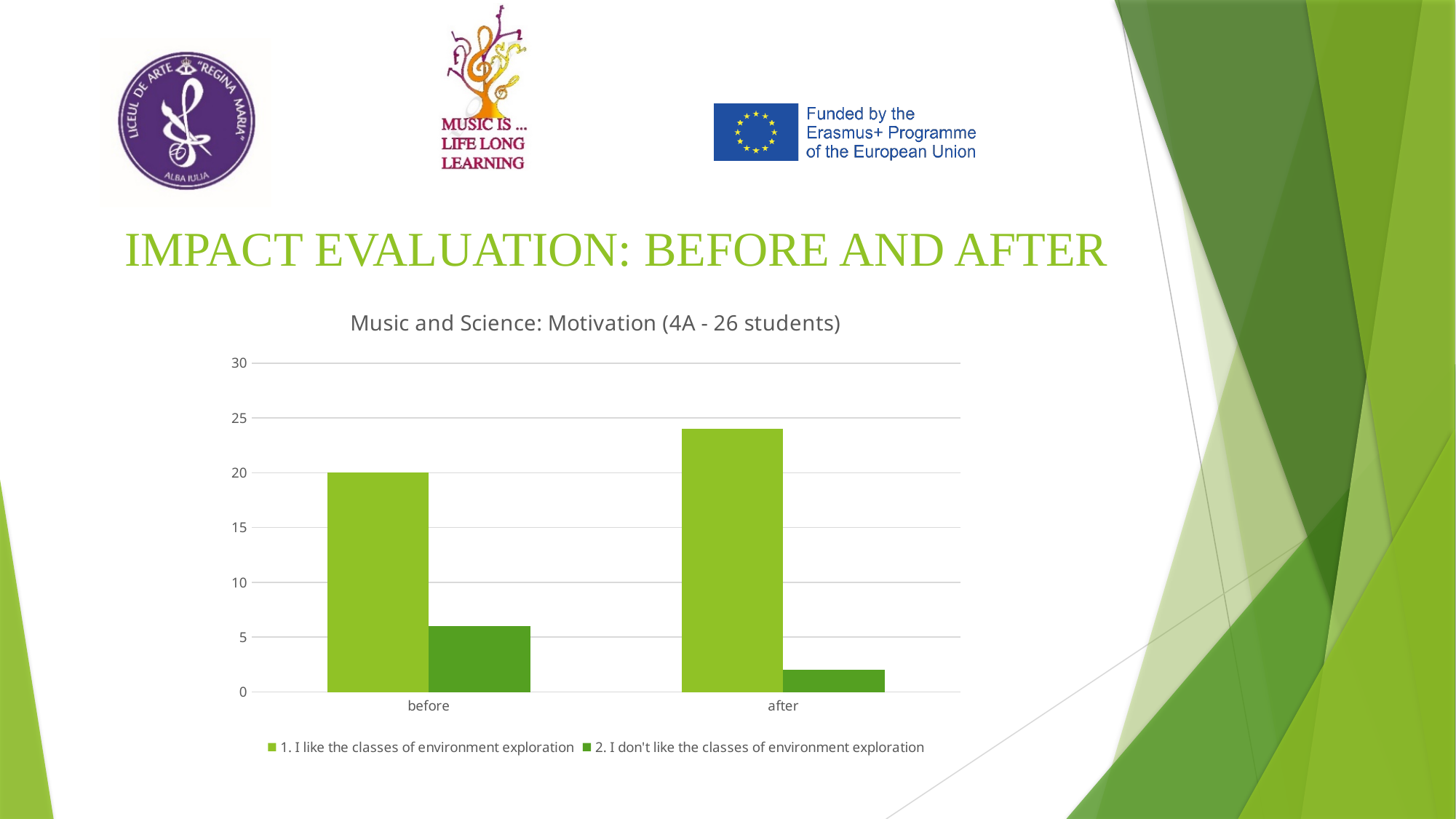
What is the value for '1. I like the classes of environment exploration' in the 'before' category? 20 What type of chart is shown on the slide? bar chart What is the title of the chart? Music and Science: Motivation (4A - 26 students) Is the value for '1. I like the classes of environment exploration' in the 'after' category greater or less than 20? greater How many series does the legend list? 2 Which category has the higher value for '1. I like the classes of environment exploration', 'before' or 'after'? after Does the value for '2. I don't like the classes of environment exploration' rise or fall from 'before' to 'after'? fall Which category has the lower value for '2. I don't like the classes of environment exploration'? after Is the value for '2. I don't like the classes of environment exploration' in the 'before' category greater or less than 10? less Which series is shown in the darker green colour? 2. I don't like the classes of environment exploration How many categories are shown on the x axis? 2 Is the value for '2. I don't like the classes of environment exploration' in the 'after' category greater or less than 5? less